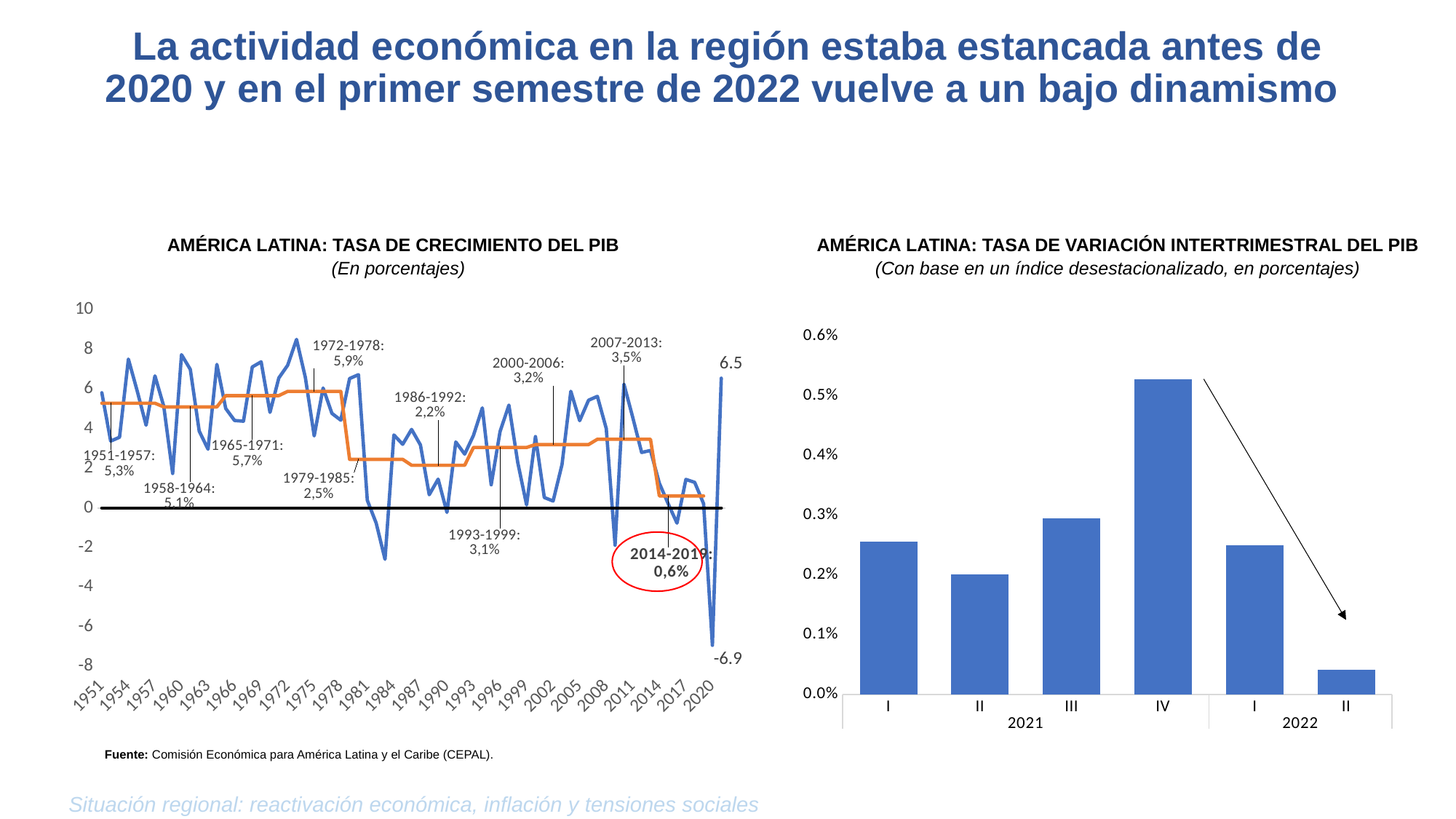
In the right chart, which quarter has the highest quarterly GDP variation? IV 2021 In the left chart, what value is labelled for the year 2020? -6.9 In the left chart, what is the difference between the average growth rate for 1972-1978 and for 1979-1985? 3,4 percentage points What kind of chart is the left chart, 'AMÉRICA LATINA: TASA DE CRECIMIENTO DEL PIB'? Line chart In the left chart, what is the average GDP growth rate labelled for the period 1972-1978? 5,9% In the left chart, what is the average GDP growth rate labelled for the period 2014-2019? 0,6% In the right chart, how many quarters (bars) are shown? 6 In the right chart, is the value for quarter II of 2022 greater or less than 0.1%? less In the left chart, which labelled period has the highest average growth rate? 1972-1978 What kind of chart is the right chart, 'AMÉRICA LATINA: TASA DE VARIACIÓN INTERTRIMESTRAL DEL PIB'? Bar chart In the right chart, which quarter has the lowest quarterly GDP variation? II 2022 In the left chart, which labelled period has the lowest average growth rate? 2014-2019